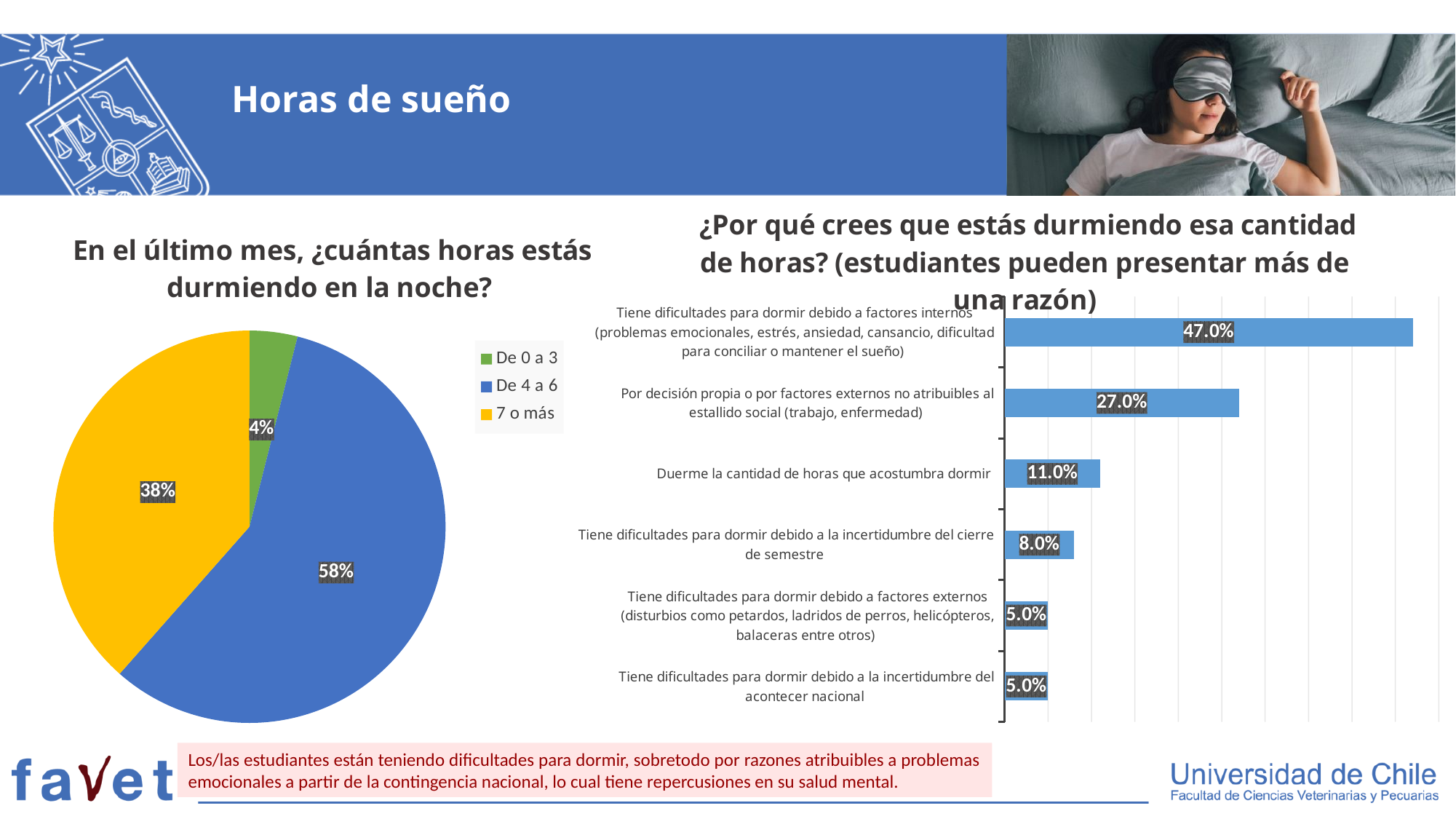
In the bar chart on the right, how many reasons (categories) are shown? 6 In the bar chart on the right, what is the value for 'Duerme la cantidad de horas que acostumbra dormir'? 11.0% In the bar chart on the right, what is the value for 'Por decisión propia o por factores externos no atribuibles al estallido social (trabajo, enfermedad)'? 27.0% In the pie chart on the left, what percentage of students sleep 'De 4 a 6' hours? 58% In the bar chart on the right, which is larger: the value for 'Tiene dificultades para dormir debido a la incertidumbre del cierre de semestre' or the value for 'Tiene dificultades para dormir debido a factores externos'? Tiene dificultades para dormir debido a la incertidumbre del cierre de semestre In the pie chart on the left, what is the difference between the 'De 4 a 6' share and the '7 o más' share? 20% In the pie chart on the left, what percentage of students sleep '7 o más' hours? 38% In the pie chart on the left, how many categories does the legend list? 3 In the bar chart on the right, which reason has the highest value? Tiene dificultades para dormir debido a factores internos (problemas emocionales, estrés, ansiedad, cansancio, dificultad para conciliar o mantener el sueño) What type of chart is shown on the right side of the slide? Bar chart In the bar chart on the right, what is the difference between the highest value (47.0%) and the value for 'Por decisión propia...' (27.0%)? 20.0% In the pie chart on the left, which category has the smallest share? De 0 a 3